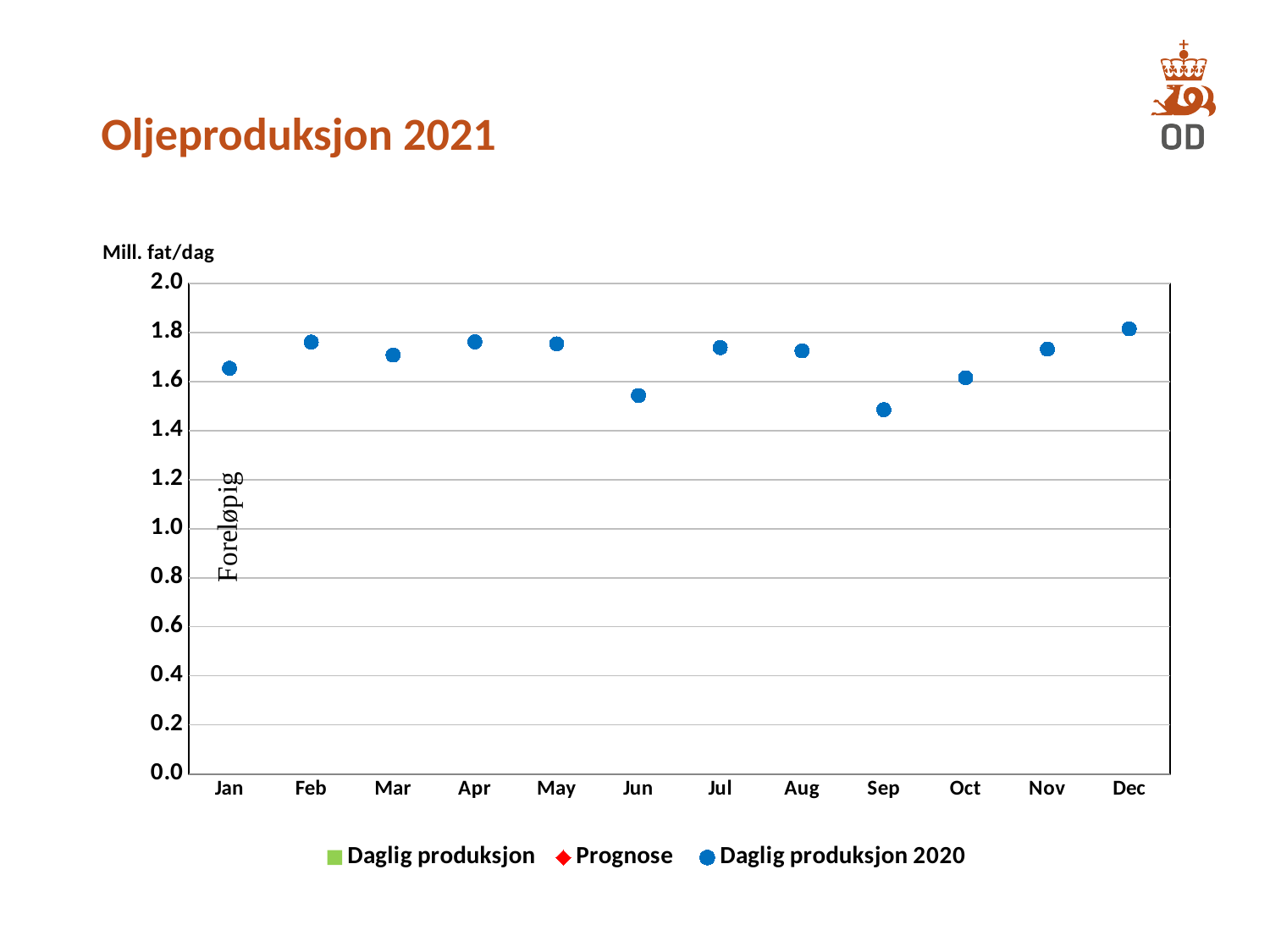
Which is larger for Daglig produksjon 2020, Jan or Sep? Jan Which is larger for Daglig produksjon 2020, Feb or Jun? Feb How many months are shown on the x axis? 12 What kind of chart is shown on the slide? Scatter (dot) chart Is the value for Daglig produksjon 2020 in Sep greater or less than 1.6? less What is the title of the chart on the slide? Oljeproduksjon 2021 Is the value for Daglig produksjon 2020 in Feb greater or less than 1.6? greater Which month has the lowest value for Daglig produksjon 2020? Sep What unit is shown on the y axis? Mill. fat/dag Which month has the highest value for Daglig produksjon 2020? Dec How many series does the legend list? 3 Is the value for Daglig produksjon 2020 in Jun greater or less than 1.6? less